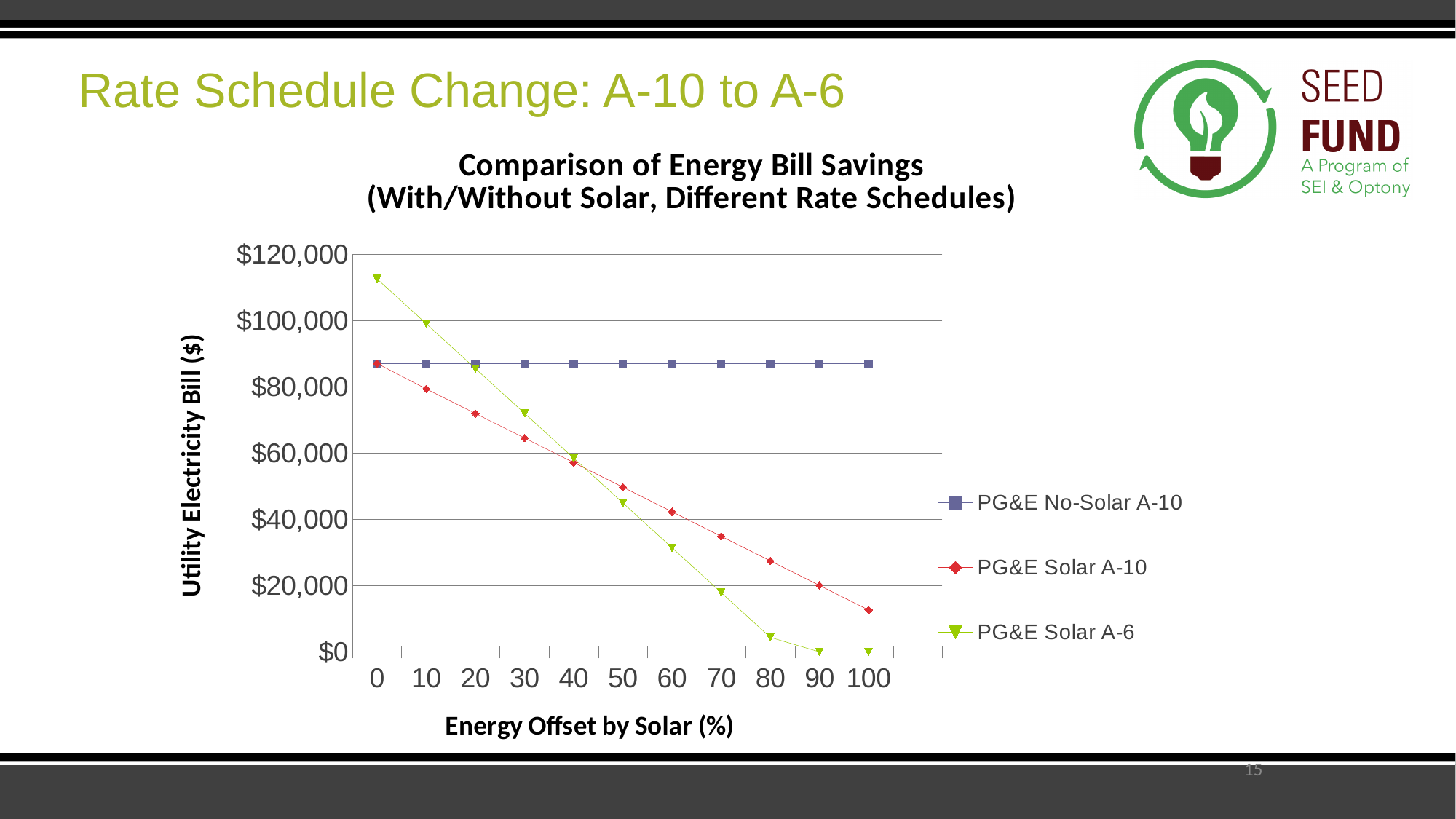
Which series has the lowest utility electricity bill at 100% energy offset by solar? PG&E Solar A-6 At 100% energy offset, which series has the higher utility electricity bill: PG&E Solar A-10 or PG&E Solar A-6? PG&E Solar A-10 Does the PG&E Solar A-6 series rise or fall as energy offset by solar increases? Fall Is the value for PG&E Solar A-10 at 100% energy offset greater or less than $20,000? less What is the utility electricity bill for PG&E Solar A-6 at 90% energy offset by solar? $0 What kind of chart is shown on the slide? Line chart What is the utility electricity bill for PG&E Solar A-6 at 100% energy offset by solar? $0 At 0% energy offset, which series has the higher utility electricity bill: PG&E Solar A-6 or PG&E No-Solar A-10? PG&E Solar A-6 Is the value for PG&E Solar A-6 at 0% energy offset greater or less than $100,000? greater Is the value for PG&E No-Solar A-10 at 50% energy offset greater or less than $80,000? greater How many data points are plotted for each series along the x axis? 11 How many series does the legend list? 3